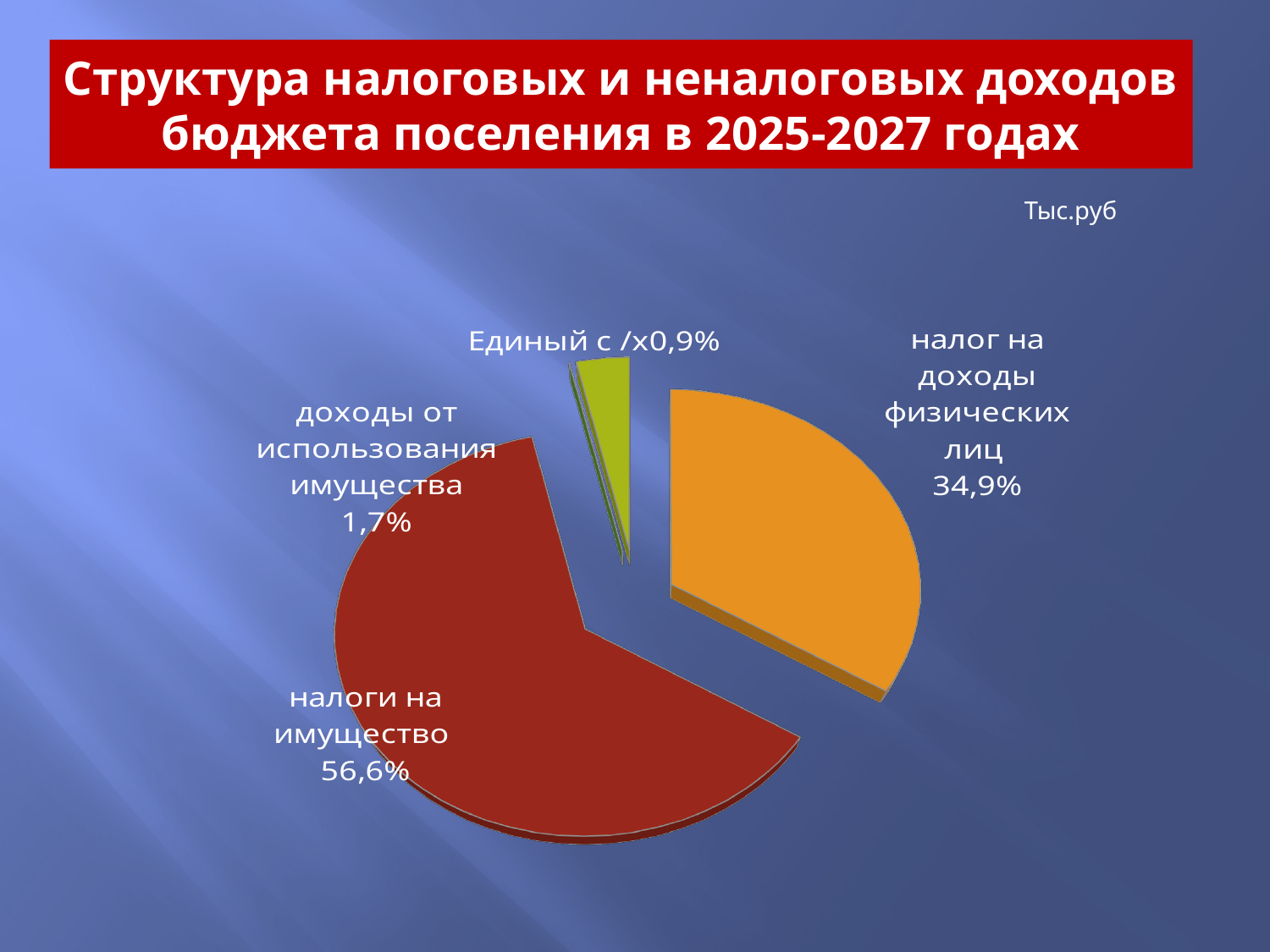
Which category has the smallest share of the pie? Единый с/х What is the title of the slide's chart? Структура налоговых и неналоговых доходов бюджета поселения в 2025-2027 годах Which is larger: the share for "налоги на имущество" or for "налог на доходы физических лиц"? налоги на имущество What share of the pie does "налоги на имущество" have? 56,6% What is the difference in percentage points between "доходы от использования имущества" and "Единый с/х"? 0,8 What colour is the slice for "налог на доходы физических лиц"? orange What type of chart is shown on the slide? pie chart What is the difference in percentage points between "налоги на имущество" and "налог на доходы физических лиц"? 21,7 What share is shown for "Единый с/х"? 0,9% What share is shown for "налог на доходы физических лиц"? 34,9% Which category has the largest share of the pie? налоги на имущество What is the value labelled for "доходы от использования имущества"? 1,7%